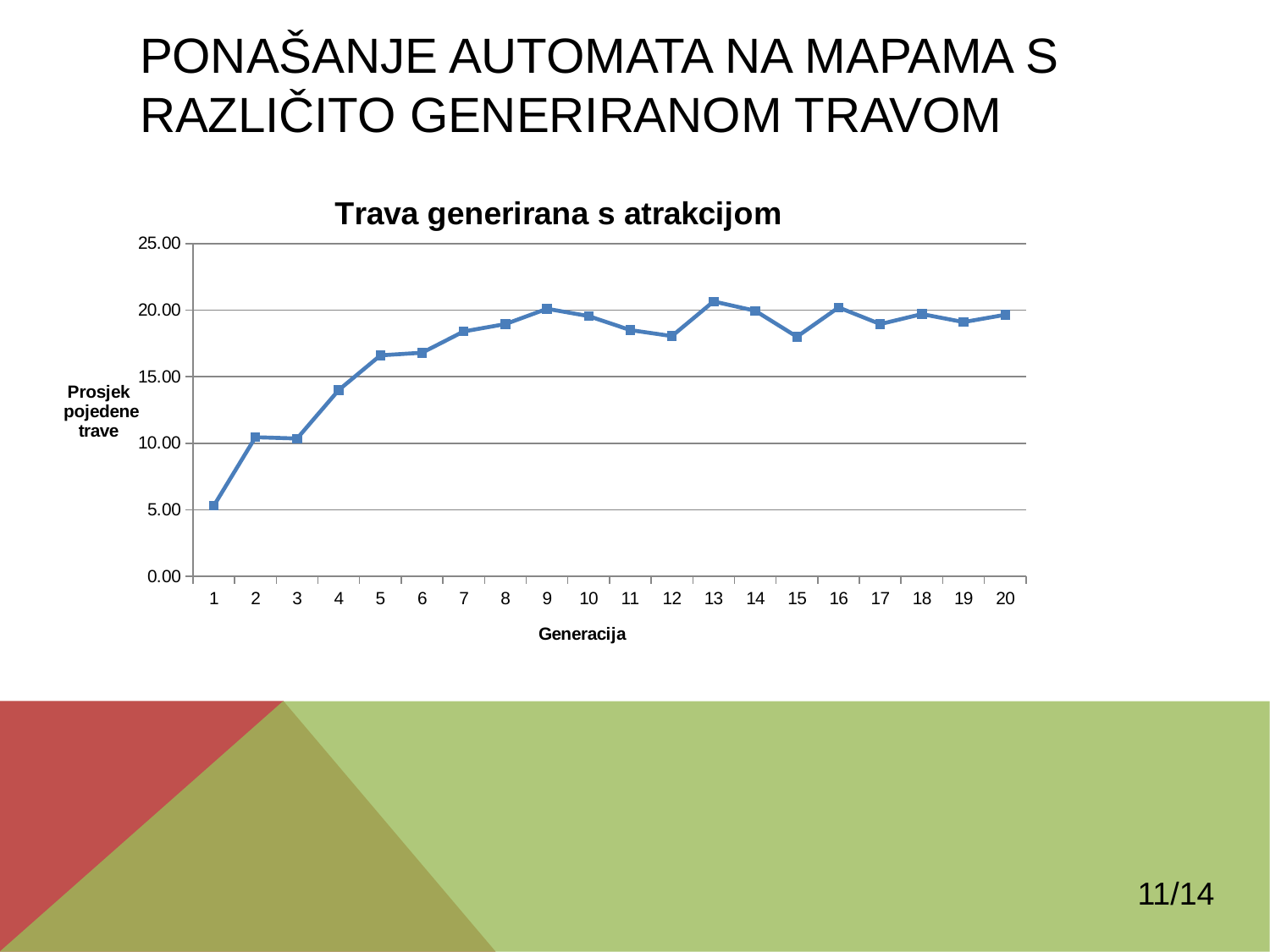
What kind of chart is shown on the slide? line chart Is the value for generation 4 greater or less than 15.00? less What is the title of the chart? Trava generirana s atrakcijom How many generations are plotted on the x axis? 20 Which generation has the highest value? 13 Is the value for generation 1 greater or less than 10.00? less Does the value generally rise or fall from generation 1 to generation 9? rise Which generation has the lowest value? 1 Is the value for generation 15 greater or less than 20.00? less Which has the larger value, generation 4 or generation 8? generation 8 What is the label of the x axis? Generacija